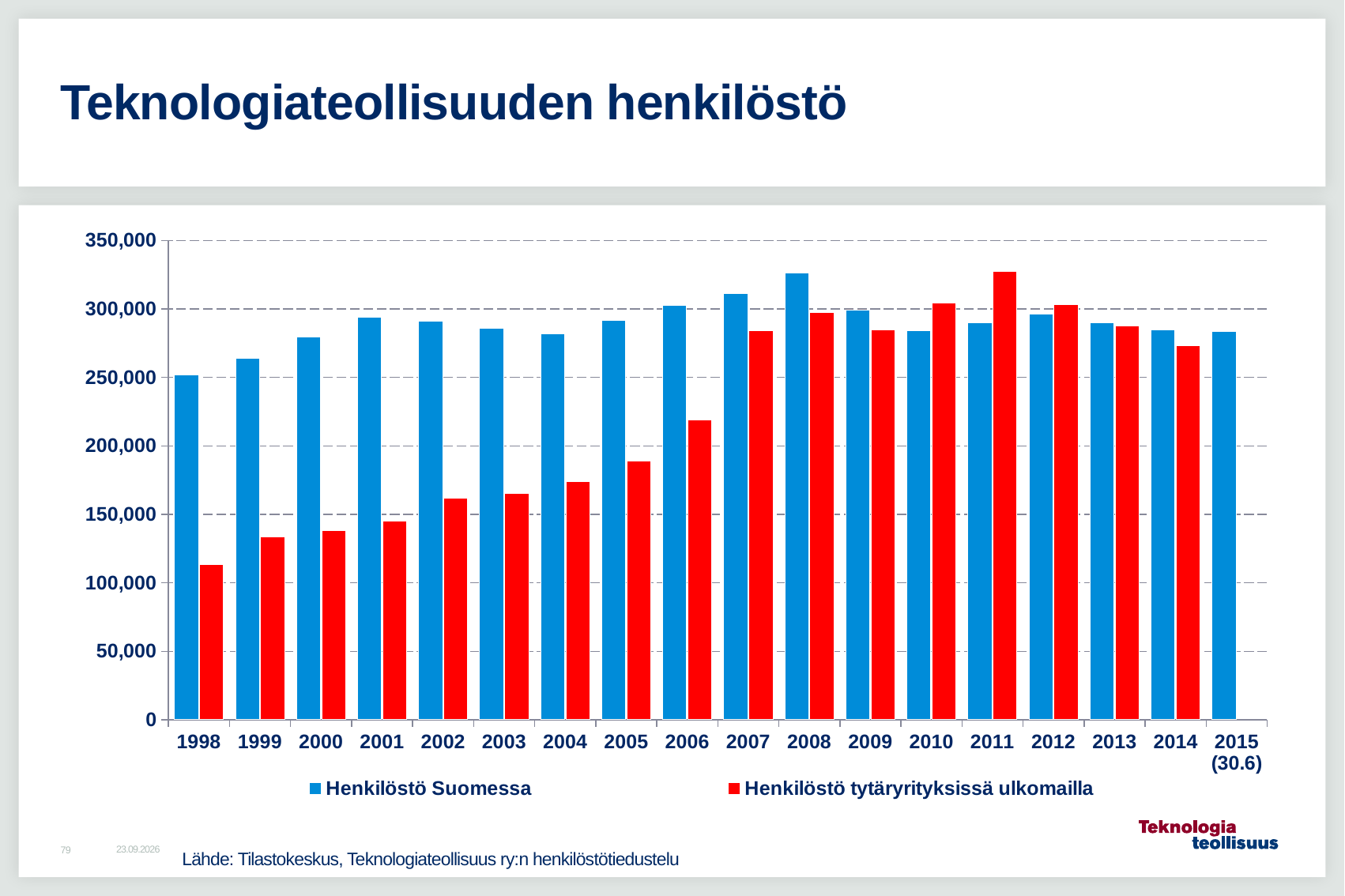
In which year is the value for Henkilöstö tytäryrityksissä ulkomailla highest? 2011 In which year is the value for Henkilöstö Suomessa highest? 2008 How many years are shown on the x axis? 18 Is the value for Henkilöstö tytäryrityksissä ulkomailla in 2006 greater or less than 200,000? greater In 2011, which series has the larger value, Henkilöstö Suomessa or Henkilöstö tytäryrityksissä ulkomailla? Henkilöstö tytäryrityksissä ulkomailla Which colour represents Henkilöstö Suomessa in the chart? blue How many series does the legend list? 2 What kind of chart is shown on the slide? bar chart Is the value for Henkilöstö Suomessa in 2008 greater or less than 300,000? greater Is the value for Henkilöstö tytäryrityksissä ulkomailla in 1998 greater or less than 150,000? less In which year is the value for Henkilöstö tytäryrityksissä ulkomailla lowest? 1998 Does the value for Henkilöstö tytäryrityksissä ulkomailla rise or fall from 1998 to 2006? rise